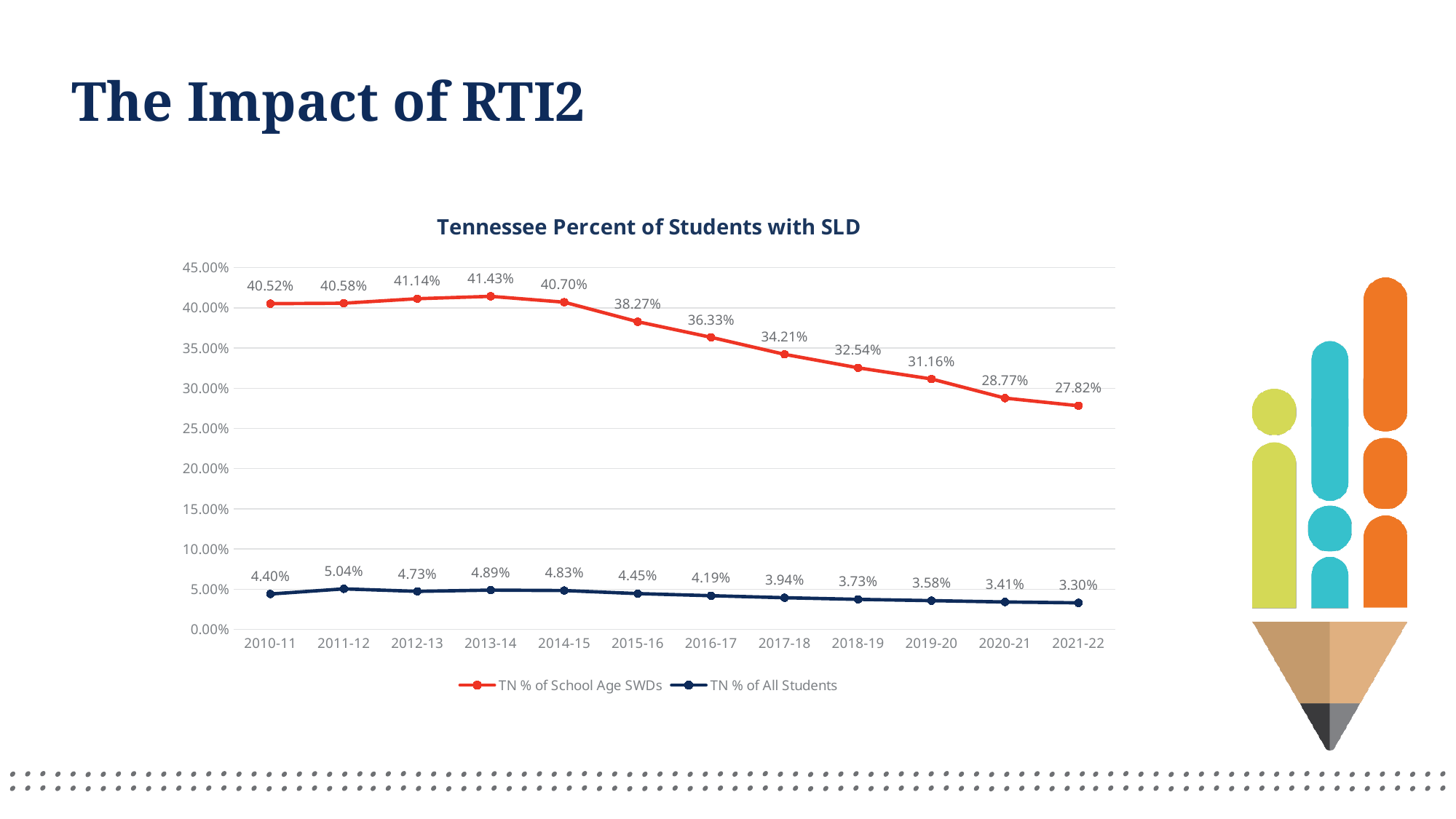
Which is larger: TN % of All Students in 2011-12 or in 2015-16? 2011-12 In which year is TN % of School Age SWDs highest? 2013-14 Does TN % of School Age SWDs rise or fall from 2014-15 to 2021-22? fall What kind of chart is shown? line chart How many series does the legend list? 2 What is the value for TN % of All Students in 2021-22? 3.30% In which year is TN % of All Students lowest? 2021-22 What is the value for TN % of School Age SWDs in 2013-14? 41.43% What is the difference between TN % of School Age SWDs in 2010-11 and 2021-22? 12.70% How many school years are shown on the x axis? 12 Is the value for TN % of School Age SWDs in 2016-17 greater or less than 35.00%? greater What is the value for TN % of School Age SWDs in 2017-18? 34.21%